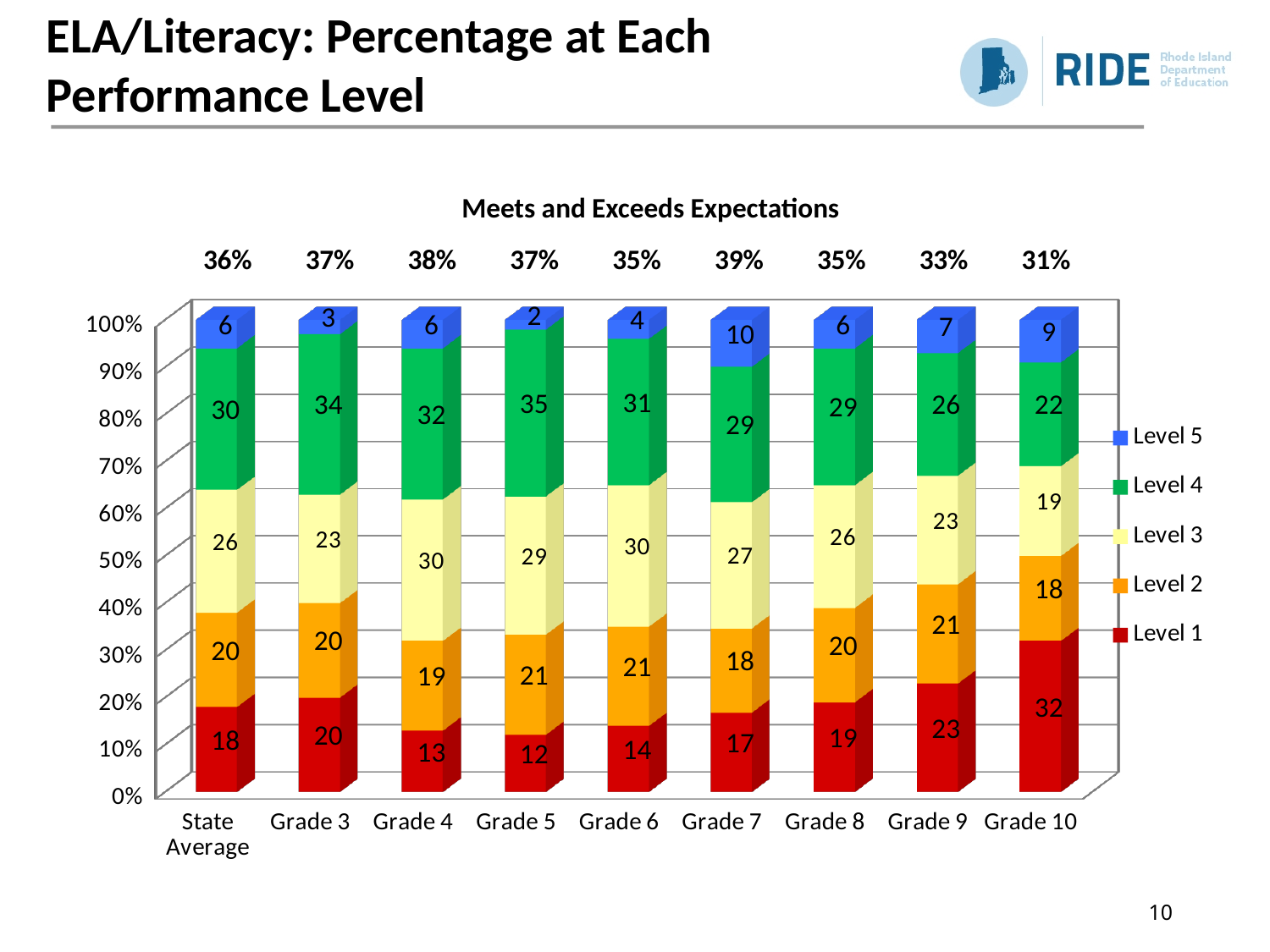
What kind of chart is shown on the slide? Stacked bar chart How many categories are shown on the x axis? 9 What is the Level 4 value for Grade 5? 35 What percentage of Grade 10 students are at Level 1? 32 Which category has the highest Level 1 value? Grade 10 What is the difference between the Level 4 values for Grade 5 and Grade 10? 13 Which legend entry is shown in red? Level 1 What is the Meets and Exceeds Expectations percentage shown for Grade 7? 39% What is the combined Level 4 and Level 5 value for Grade 7? 39 Which category has the lowest Level 5 value? Grade 5 Which is larger, the Level 3 value for Grade 4 or for Grade 9? Grade 4 How many series does the legend list? 5